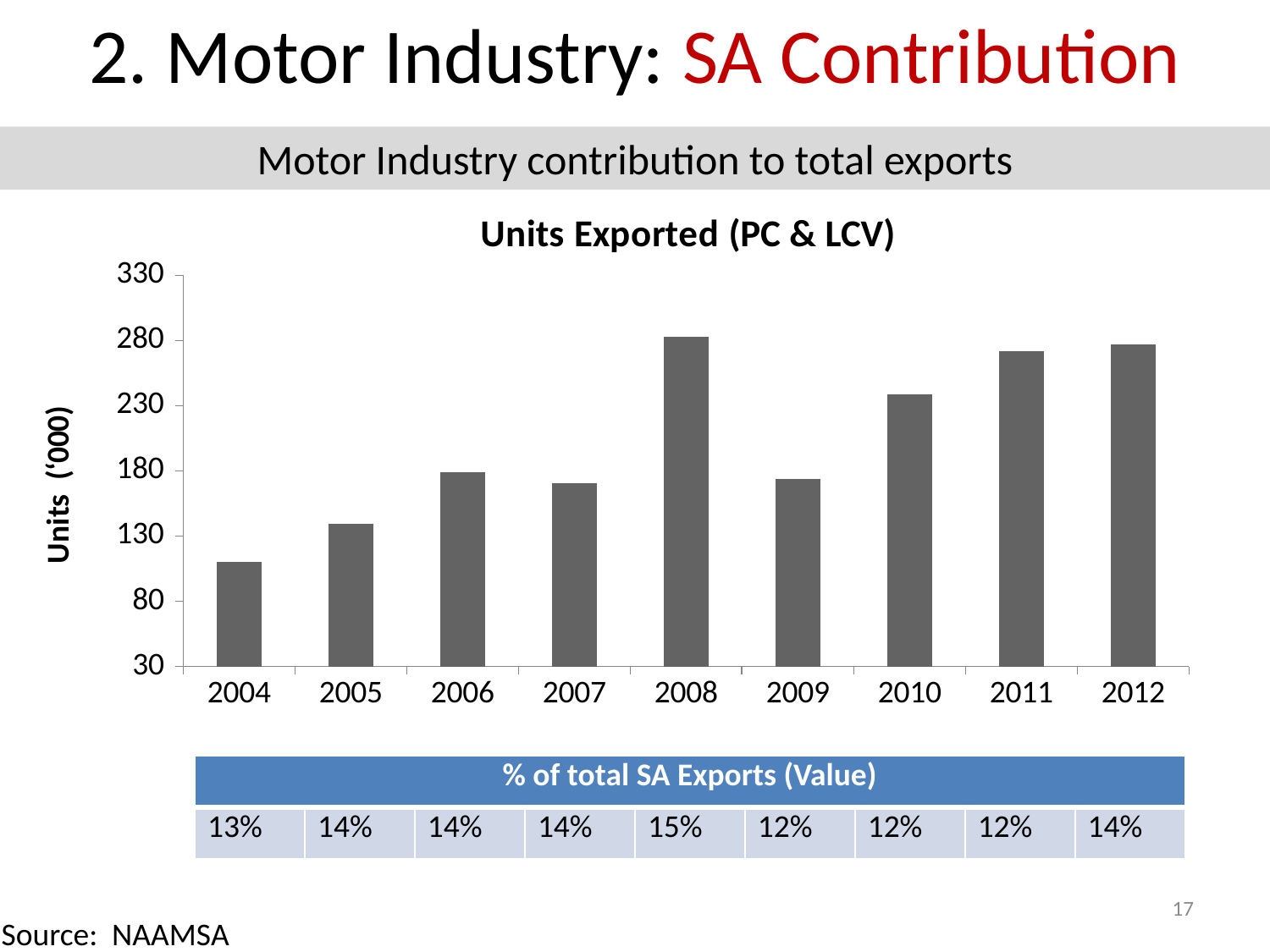
How many years are shown on the x axis of the Units Exported (PC & LCV) chart? 9 Which year has the larger value, 2004 or 2005? 2005 What kind of chart is shown on the slide? Bar chart Is the value for 2004 greater or less than 130? less Is the value for 2005 greater or less than 180? less Is the value for 2011 greater or less than 230? greater What is the label on the y axis of the chart? Units ('000) Which year has the larger value, 2010 or 2011? 2011 Do the values rise or fall from 2004 to 2006? rise Which year has the lowest number of units exported? 2004